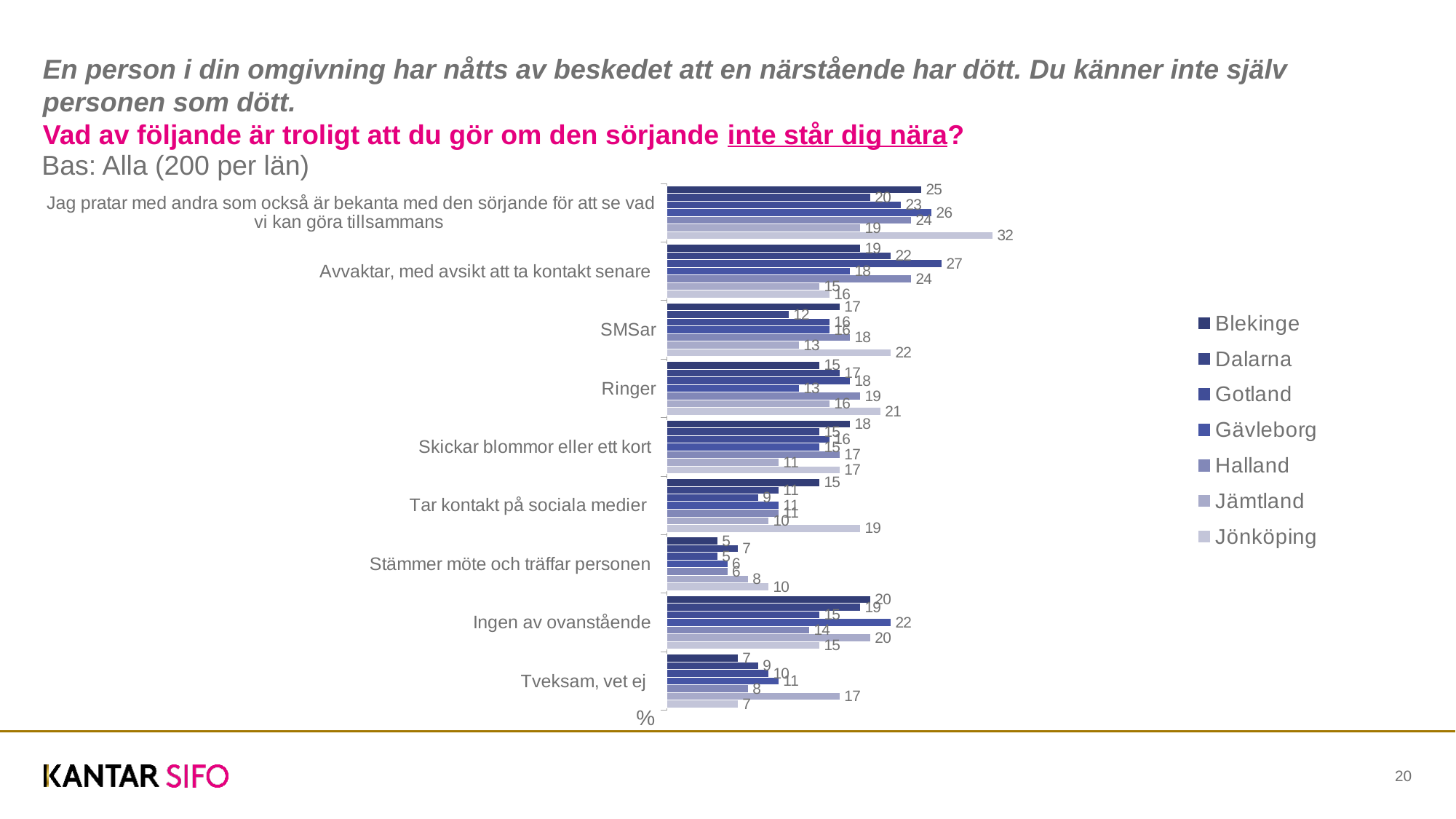
What kind of chart is shown on the slide? Bar chart In the category "SMSar", which is larger: the value for Jönköping or the value for Dalarna? Jönköping What is the value for Gävleborg in the category "Ingen av ovanstående"? 22 Which county is listed first in the legend? Blekinge What is the value for Gotland in the category "Avvaktar, med avsikt att ta kontakt senare"? 27 What is the value for Jönköping in the category "Jag pratar med andra som också är bekanta med den sörjande för att se vad vi kan göra tillsammans"? 32 How many series does the legend list? 7 What is the value for Jämtland in the category "Tveksam, vet ej"? 17 What is the difference between Jönköping and Jämtland in the category "Jag pratar med andra som också är bekanta med den sörjande för att se vad vi kan göra tillsammans"? 13 Which county has the highest value in the category "Jag pratar med andra som också är bekanta med den sörjande för att se vad vi kan göra tillsammans"? Jönköping Which county has the lowest value in the category "SMSar"? Dalarna How many response categories are shown on the chart? 9